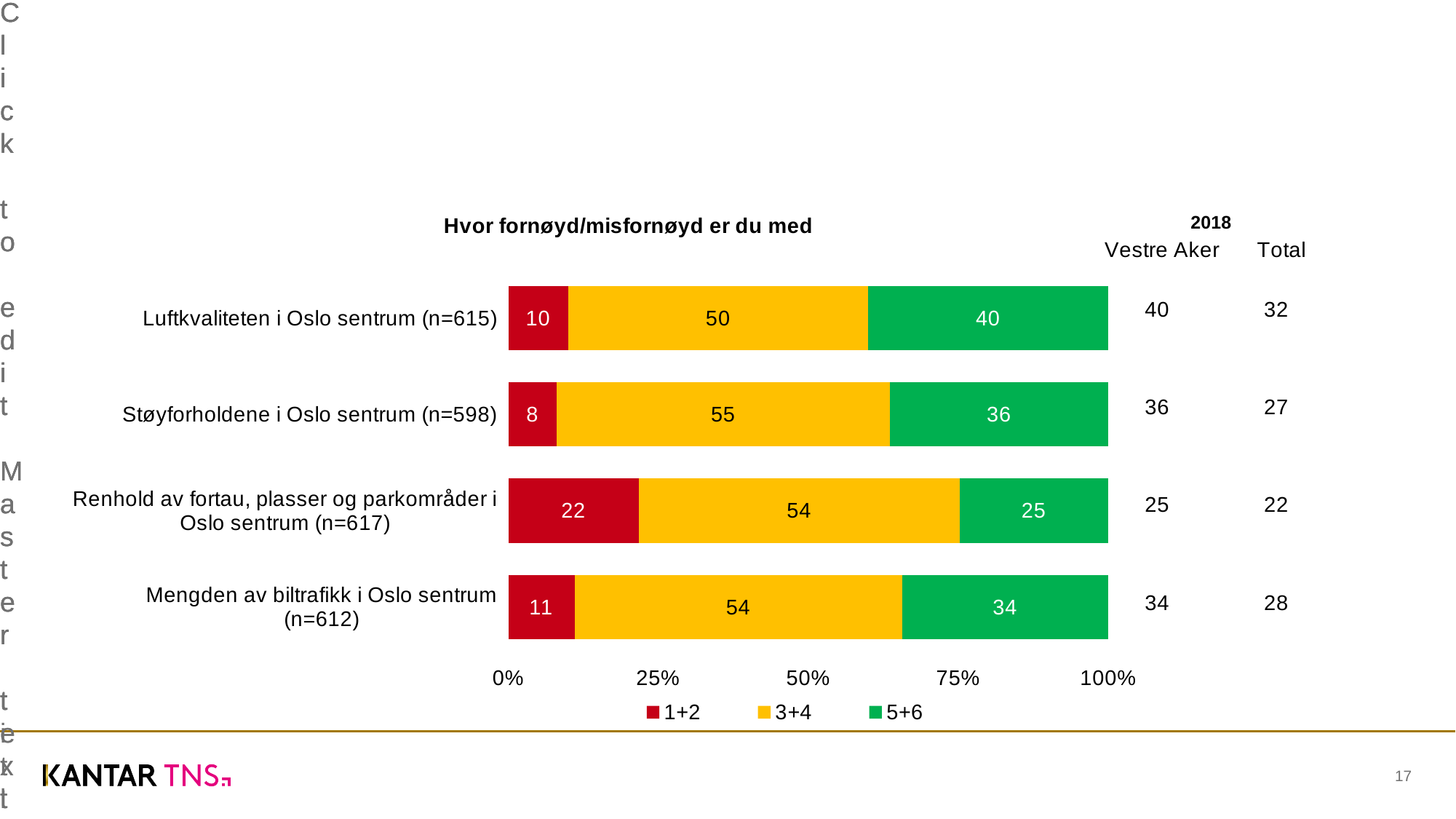
What is the value of the 5+6 series for Luftkvaliteten i Oslo sentrum (n=615)? 40 What is the value of the 1+2 series for Renhold av fortau, plasser og parkområder i Oslo sentrum (n=617)? 22 How many series does the legend list? 3 Which is larger: the 1+2 value for Mengden av biltrafikk i Oslo sentrum (n=612) or the 1+2 value for Støyforholdene i Oslo sentrum (n=598)? Mengden av biltrafikk i Oslo sentrum (n=612) Which category has the lowest value for the 5+6 series? Renhold av fortau, plasser og parkområder i Oslo sentrum (n=617) What is the title of the chart? Hvor fornøyd/misfornøyd er du med What is the total of the stacked bar for Støyforholdene i Oslo sentrum (n=598)? 99 What kind of chart is shown on the slide? Stacked bar chart What is the value of the 3+4 series for Støyforholdene i Oslo sentrum (n=598)? 55 How many categories are shown in the chart? 4 Which category has the highest value for the 1+2 series? Renhold av fortau, plasser og parkområder i Oslo sentrum (n=617) What is the difference between the 5+6 values for Luftkvaliteten i Oslo sentrum (n=615) and Mengden av biltrafikk i Oslo sentrum (n=612)? 6